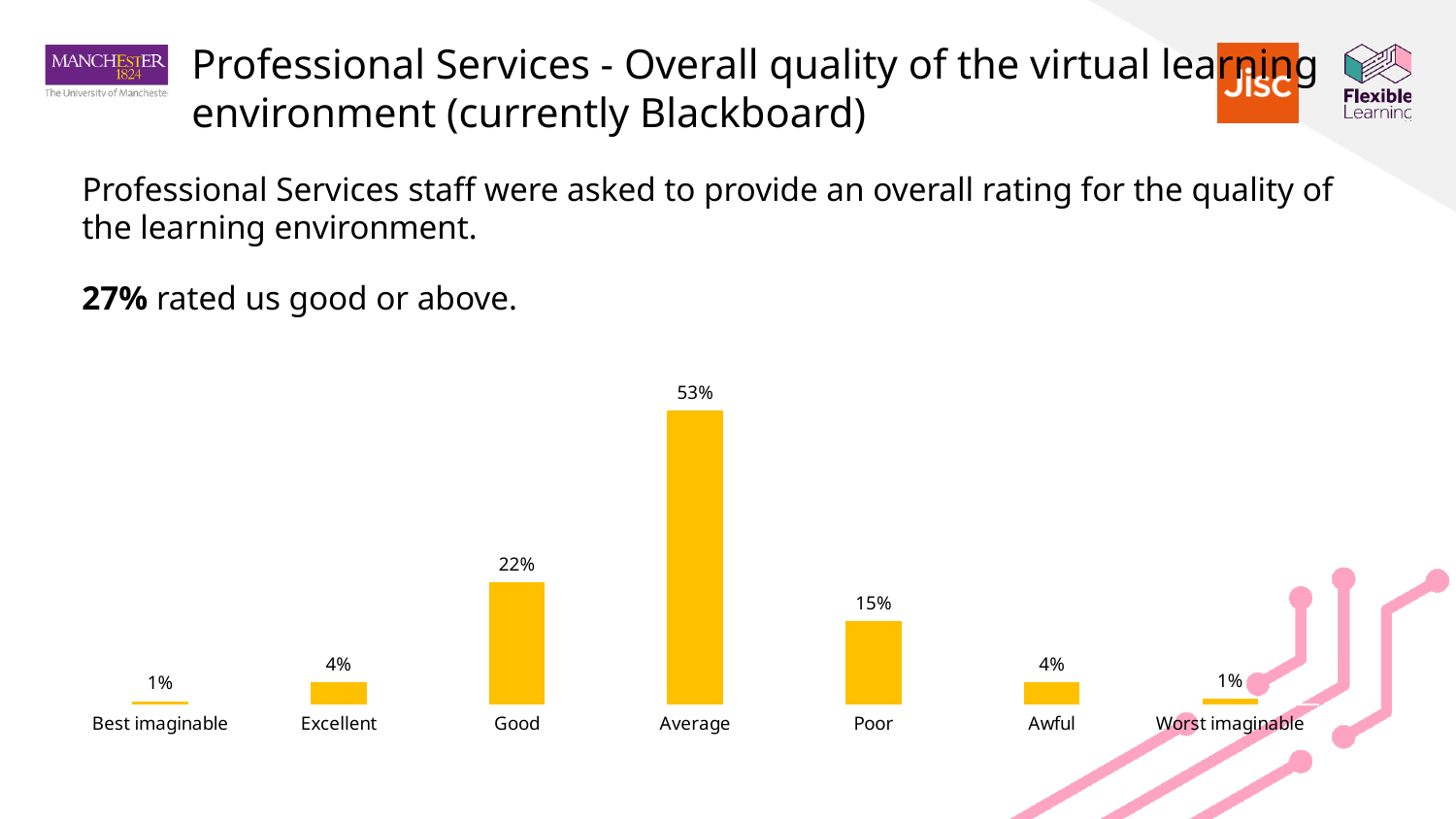
Which rating category has the highest percentage? Average What percentage of Professional Services staff rated the virtual learning environment as Average? 53% What colour are the bars in the chart? Yellow How many rating categories are shown on the chart? 7 What is the difference in percentage points between the Average and Good ratings? 31 What percentage rated the virtual learning environment as Good? 22% What is the difference in percentage points between the Good and Poor ratings? 7 What is the combined percentage of the Best imaginable, Excellent and Good ratings? 27% What percentage rated the virtual learning environment as Poor? 15% Which has a larger percentage, Poor or Excellent? Poor What type of chart is shown on the slide? Bar chart What percentage rated the virtual learning environment as Excellent? 4%